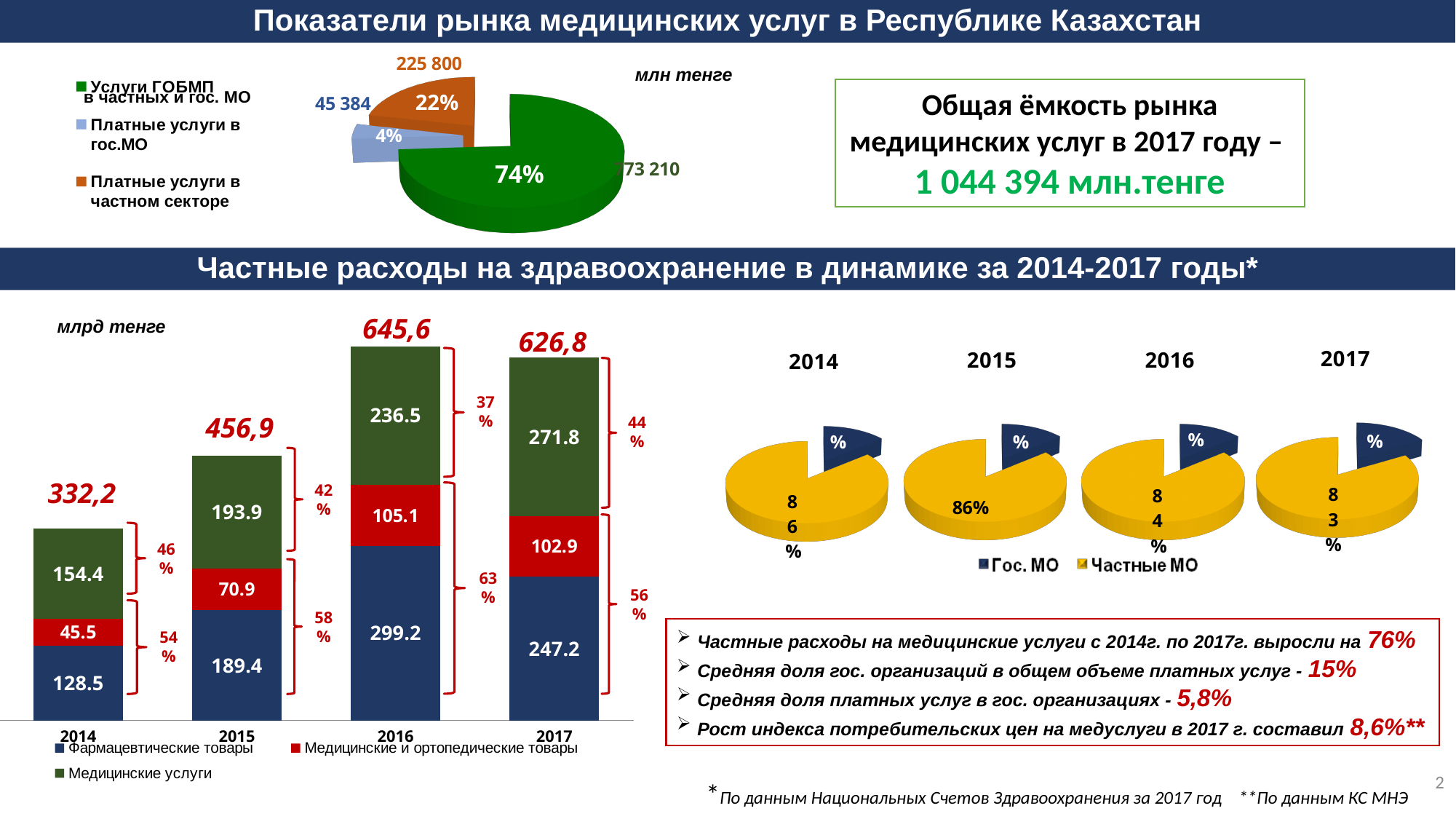
In the stacked bar chart 'Частные расходы на здравоохранение', what is the value for 'Фармацевтические товары' in 2016? 299.2 In the top pie chart, what percentage share is shown for 'Платные услуги в частном секторе'? 22% What type of chart is used for 'Частные расходы на здравоохранение в динамике за 2014-2017 годы'? Stacked bar chart In the stacked bar chart 'Частные расходы на здравоохранение', what is the difference between 'Медицинские и ортопедические товары' in 2016 and in 2015? 34.2 In the top pie chart, what value is printed for 'Платные услуги в гос.МО'? 45 384 In the stacked bar chart 'Частные расходы на здравоохранение', what is the value for 'Медицинские услуги' in 2014? 154.4 In the stacked bar chart 'Частные расходы на здравоохранение', what is the total for 2017? 626,8 In the stacked bar chart 'Частные расходы на здравоохранение', how many series does the legend list? 3 In the small pie charts on the right, what share is shown for 'Частные МО' in 2016? 84% In the top pie chart, which category has the largest share? Услуги ГОБМП в частных и гос. МО In the stacked bar chart 'Частные расходы на здравоохранение', which year has the highest total? 2016 In the top pie chart, how many slices are there? 3